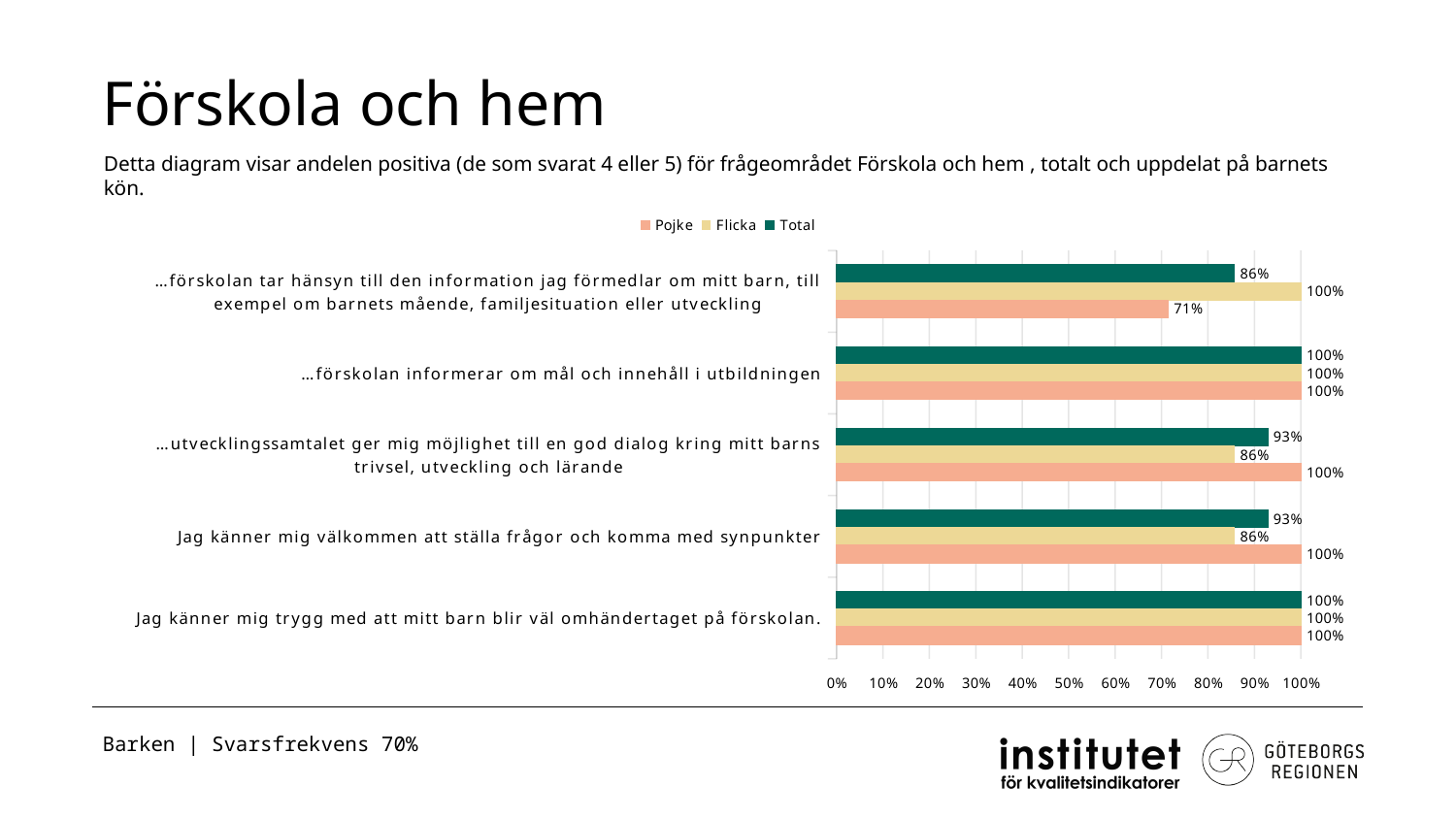
What is the Total value for "…förskolan tar hänsyn till den information jag förmedlar om mitt barn, till exempel om barnets mående, familjesituation eller utveckling"? 86% What kind of chart is shown on the slide? Bar chart What is the Total value for "…utvecklingssamtalet ger mig möjlighet till en god dialog kring mitt barns trivsel, utveckling och lärande"? 93% What is the difference between the Flicka and Pojke values for "…förskolan tar hänsyn till den information jag förmedlar om mitt barn, till exempel om barnets mående, familjesituation eller utveckling"? 29% What is the Pojke value for "…förskolan tar hänsyn till den information jag förmedlar om mitt barn, till exempel om barnets mående, familjesituation eller utveckling"? 71% What is the Flicka value for "Jag känner mig välkommen att ställa frågor och komma med synpunkter"? 86% For "Jag känner mig välkommen att ställa frågor och komma med synpunkter", which is larger, the Pojke value or the Flicka value? Pojke Which category has the lowest Pojke value? …förskolan tar hänsyn till den information jag förmedlar om mitt barn, till exempel om barnets mående, familjesituation eller utveckling Which series is shown in green in the chart? Total How many series does the legend list? 3 What is the Pojke value for "Jag känner mig trygg med att mitt barn blir väl omhändertaget på förskolan."? 100% How many categories (statements) are shown in the chart? 5